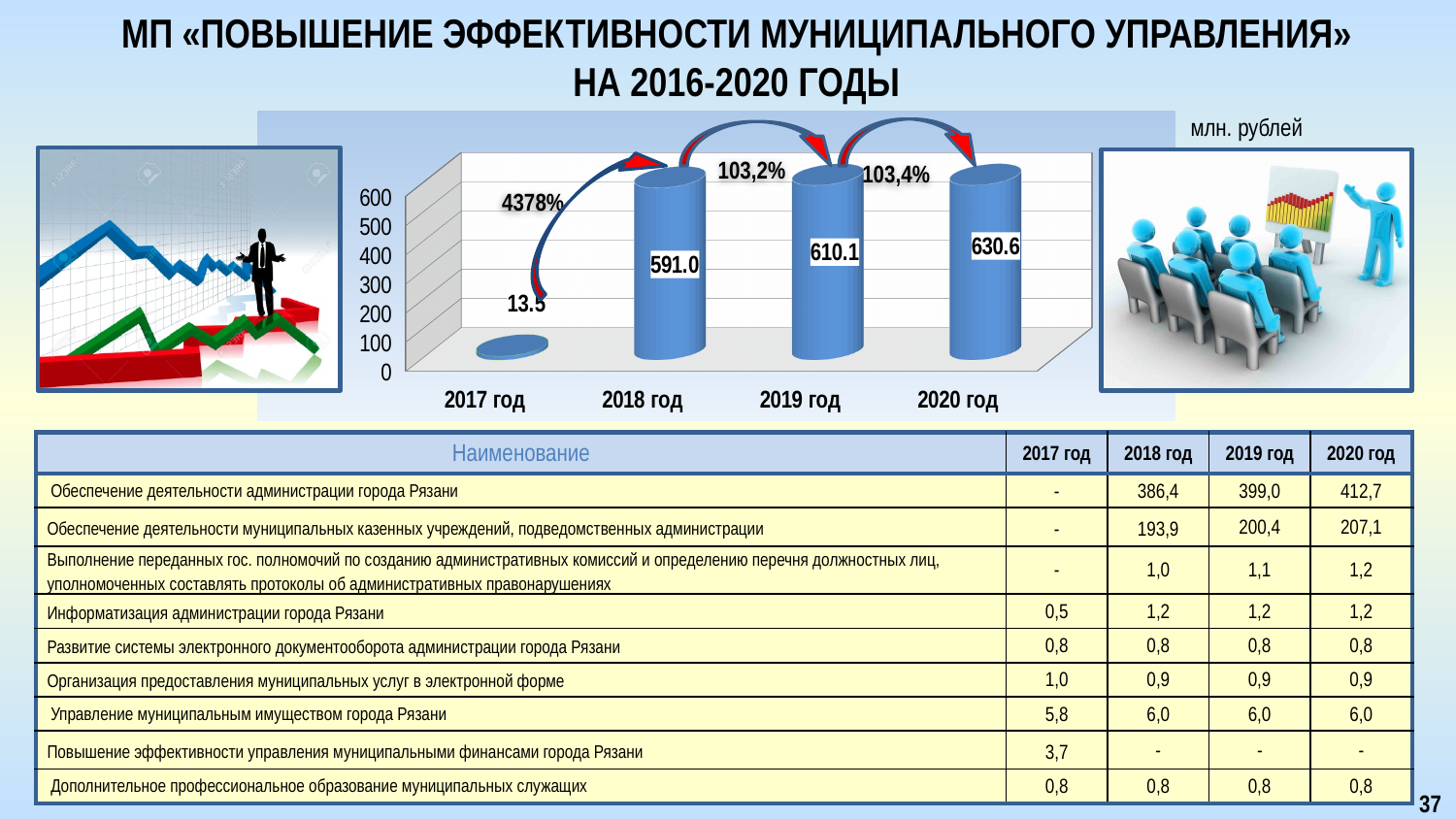
Which year has the lowest value in the chart? 2017 год What is the value for 2018 год in the chart? 591.0 How many years are shown on the x axis of the chart? 4 Which year has the highest value in the chart? 2020 год Which is larger, the value for 2019 год or the value for 2018 год? 2019 год What kind of chart is shown on the slide? bar chart What is the value for 2017 год in the chart? 13.5 What is the difference between the values for 2020 год and 2019 год? 20.5 Is the value for 2019 год greater or less than 600? greater What is the value for 2020 год in the chart? 630.6 What unit is indicated for the chart values? млн. рублей What is the difference between the values for 2018 год and 2017 год? 577.5